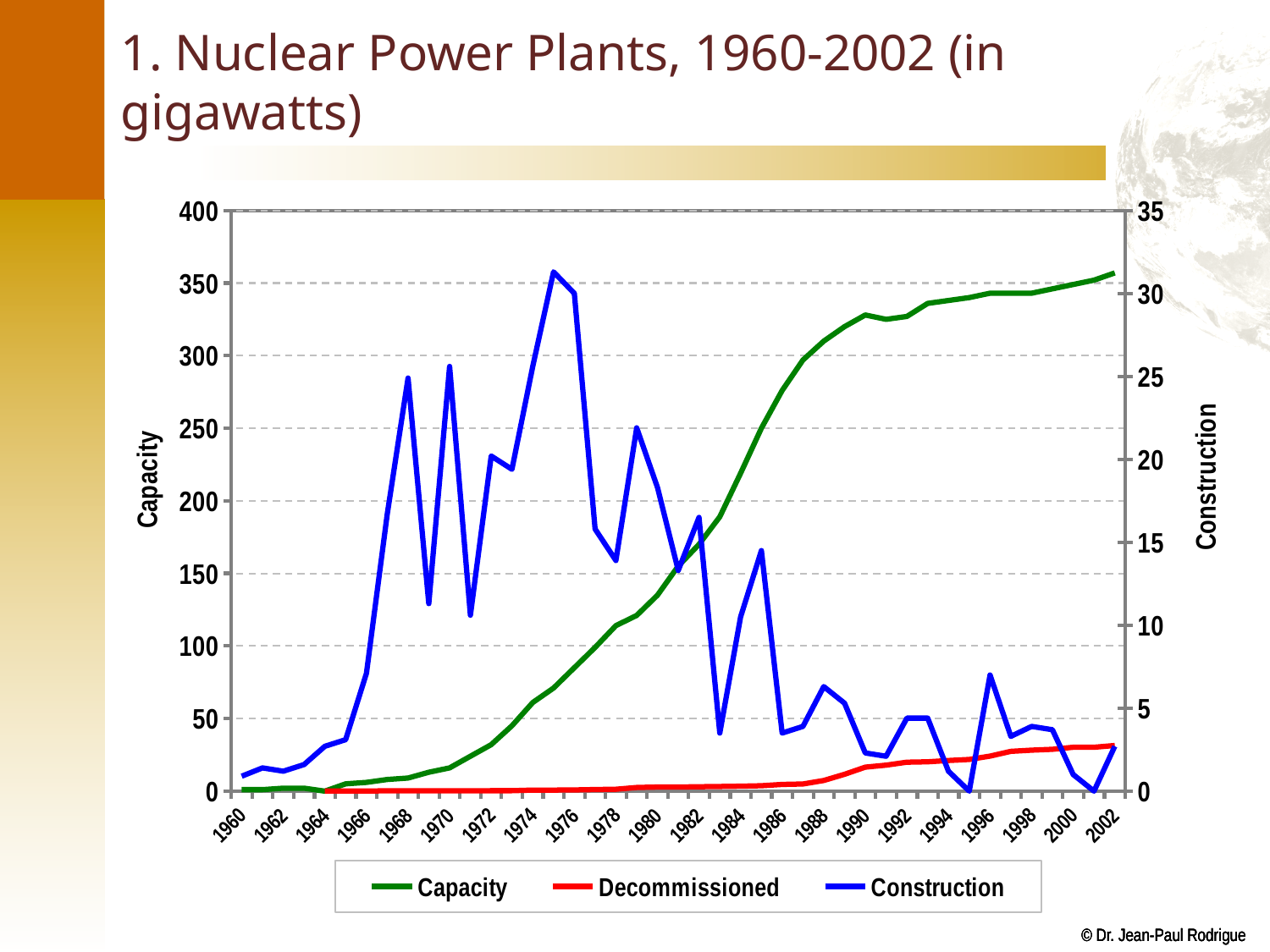
How many series does the legend list? 3 Which is larger, the Construction value in 1975 or in 1985? 1975 Is the Construction value for 1968 greater or less than 20? greater Is the Capacity value for 1980 greater or less than 150? less What kind of chart is shown on the slide? line chart Is the Capacity value for 2002 greater or less than 300? greater Does the Capacity series generally rise or fall from 1960 to 2002? rise Which series is drawn in blue? Construction Which is larger, the Capacity value in 1990 or in 2002? 2002 What is the title of the right-hand vertical axis? Construction